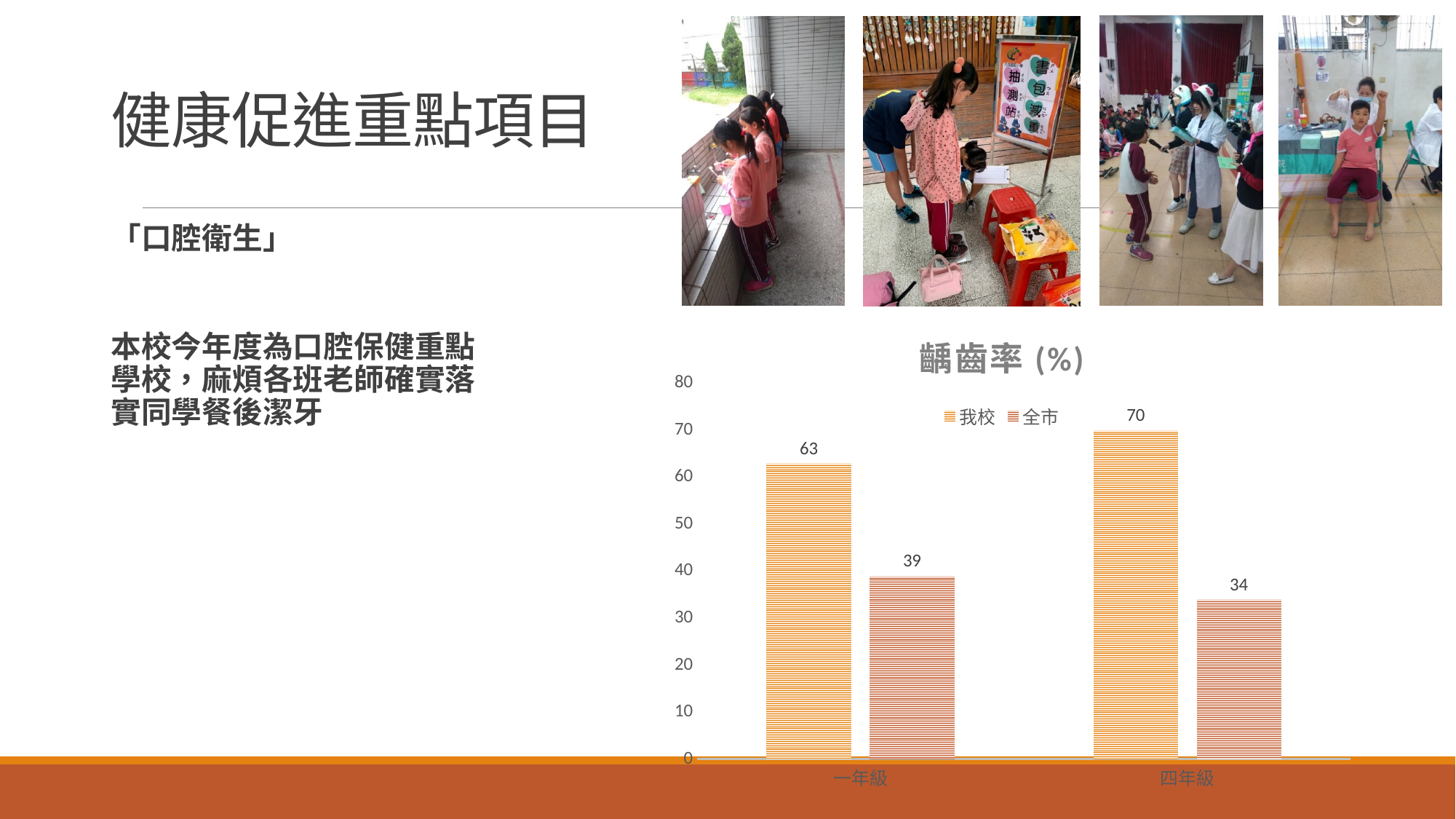
What is the value for 我校 in the 一年級 category? 63 Which category has the lowest 全市 value? 四年級 What is the value for 全市 in the 四年級 category? 34 What is the title of the chart? 齲齒率 (%) How many series does the legend list? 2 What is the value for 我校 in the 四年級 category? 70 Which is larger for 四年級, 我校 or 全市? 我校 How many categories are shown on the x axis? 2 What is the difference between the 我校 and 全市 values for 四年級? 36 What is the value for 全市 in the 一年級 category? 39 Which category has the highest 我校 value? 四年級 What is the difference between the 我校 and 全市 values for 一年級? 24